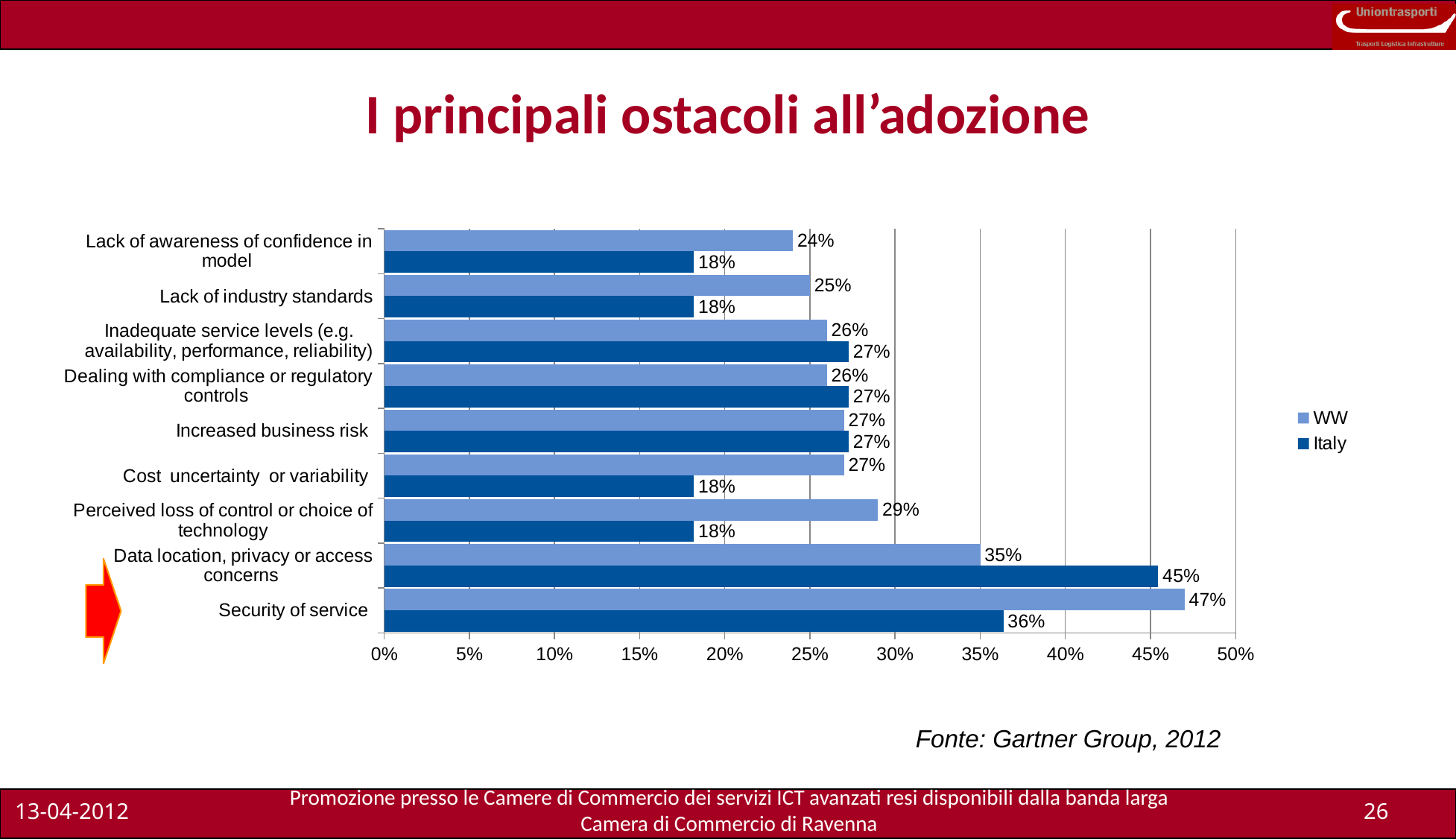
What is the WW value for Perceived loss of control or choice of technology? 29% How many categories are shown on the chart? 9 For Security of service, which is larger, the WW value or the Italy value? WW What is the difference between the Italy and WW values for Data location, privacy or access concerns? 10% What source is cited for the chart? Gartner Group, 2012 Which category has the highest WW value? Security of service What kind of chart is shown on the slide? Bar chart How many series does the legend list? 2 What is the WW value for Security of service? 47% What is the Italy value for Data location, privacy or access concerns? 45% What is the Italy value for Cost uncertainty or variability? 18% Which category has the highest Italy value? Data location, privacy or access concerns